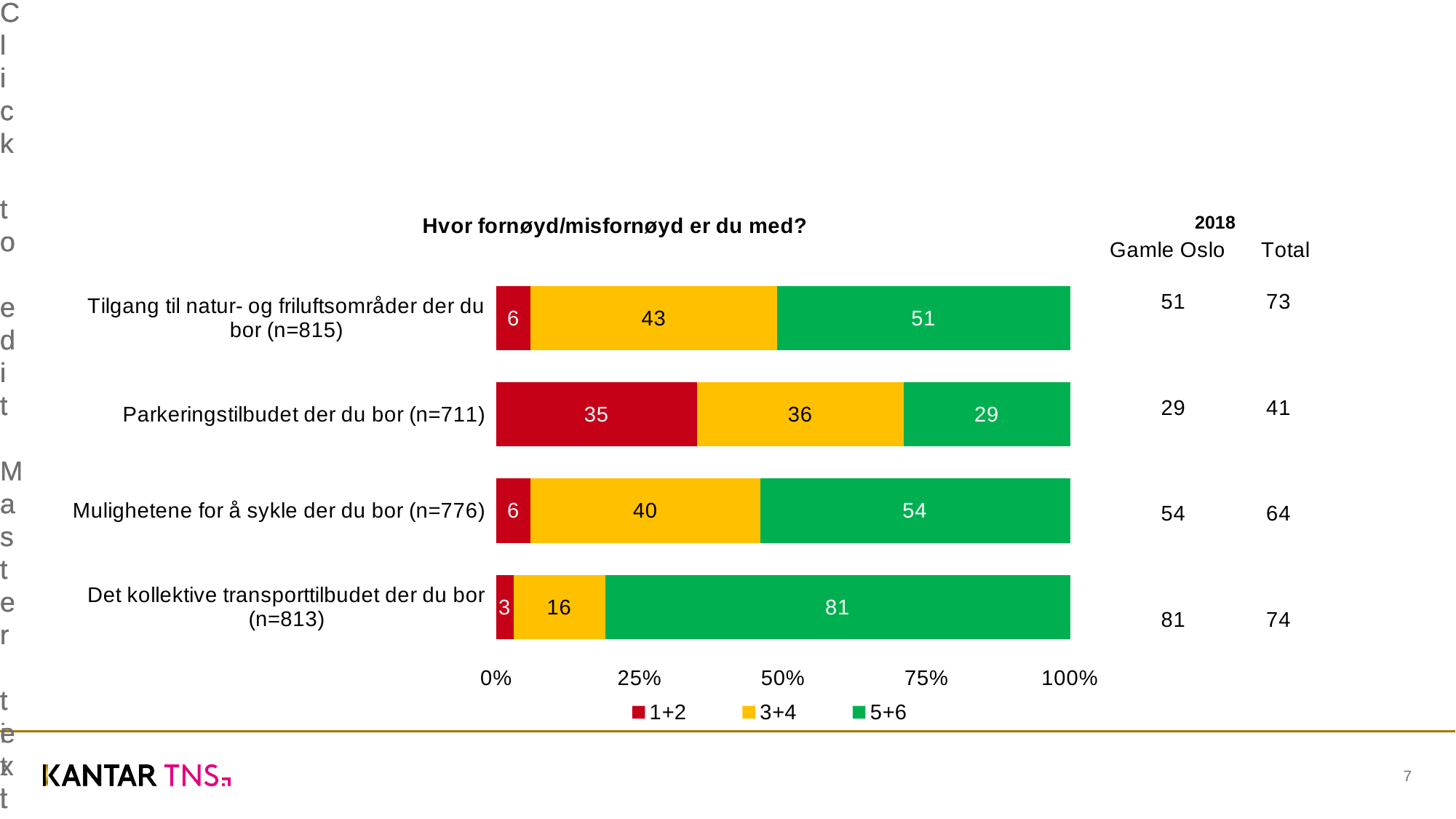
What is the title of the chart? Hvor fornøyd/misfornøyd er du med? What is the value of the 3+4 series for "Tilgang til natur- og friluftsområder der du bor (n=815)"? 43 What kind of chart is shown on the slide? Stacked bar chart What is the value of the 1+2 series for "Parkeringstilbudet der du bor (n=711)"? 35 Which category has the lowest value for the 5+6 series? Parkeringstilbudet der du bor (n=711) How many categories are shown in the chart? 4 Which category has the highest value for the 5+6 series? Det kollektive transporttilbudet der du bor (n=813) What is the total of the stacked bar for "Mulighetene for å sykle der du bor (n=776)"? 100 What is the value of the 5+6 series for "Det kollektive transporttilbudet der du bor (n=813)"? 81 How many series does the legend list? 3 Which is larger: the 3+4 value for "Parkeringstilbudet der du bor (n=711)" or the 3+4 value for "Det kollektive transporttilbudet der du bor (n=813)"? Parkeringstilbudet der du bor (n=711) What is the difference between the 5+6 values for "Mulighetene for å sykle der du bor (n=776)" and "Tilgang til natur- og friluftsområder der du bor (n=815)"? 3